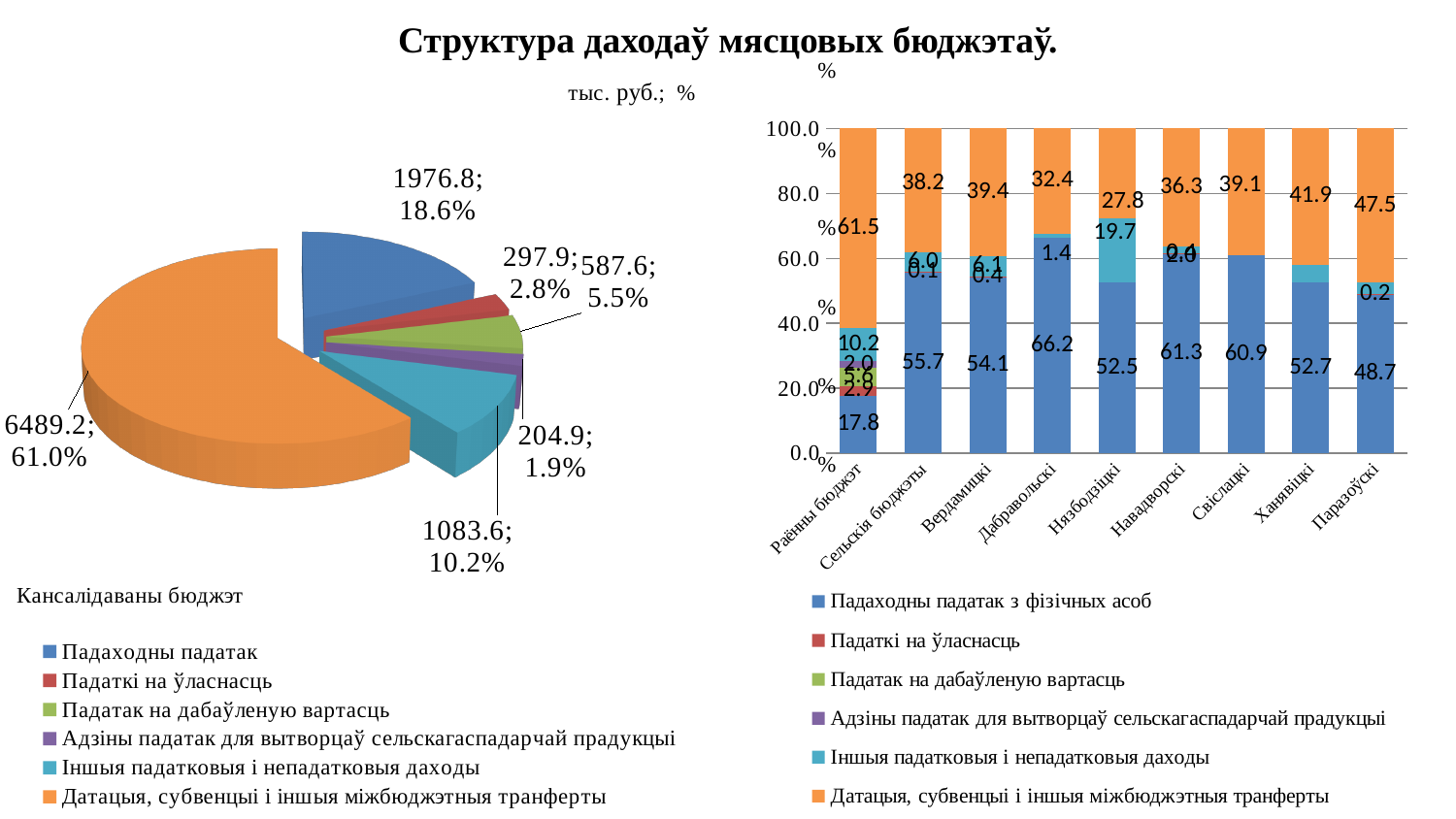
In the right bar chart, which category has the lowest value for Падаходны падатак з фізічных асоб? Раённы бюджэт In the left pie chart, what is the difference in тыс. руб. between Падаходны падатак (1976.8) and Іншыя падатковыя і непадатковыя даходы (1083.6)? 893.2 How many series does the legend of the right bar chart list? 6 In the left pie chart, which category has the largest slice? Датацыя, субвенцыі і іншыя міжбюджэтныя трансферты In the right bar chart, which category has the highest value for Датацыя, субвенцыі і іншыя міжбюджэтныя трансферты? Раённы бюджэт In the left pie chart, what share does Датацыя, субвенцыі і іншыя міжбюджэтныя трансферты have? 61.0% How many budget categories are shown on the x axis of the right bar chart? 9 In the left pie chart, what is the value (тыс. руб.) for Падаходны падатак? 1976.8 In the right bar chart, what is the difference between the Падаходны падатак з фізічных асоб values for Дабравольскі (66.2) and Паразоўскі (48.7)? 17.5 What kind of chart is the left chart (Кансалідаваны бюджэт)? pie chart What kind of chart is the right chart? stacked bar chart In the right bar chart, what is the value of Падаходны падатак з фізічных асоб for Дабравольскі? 66.2